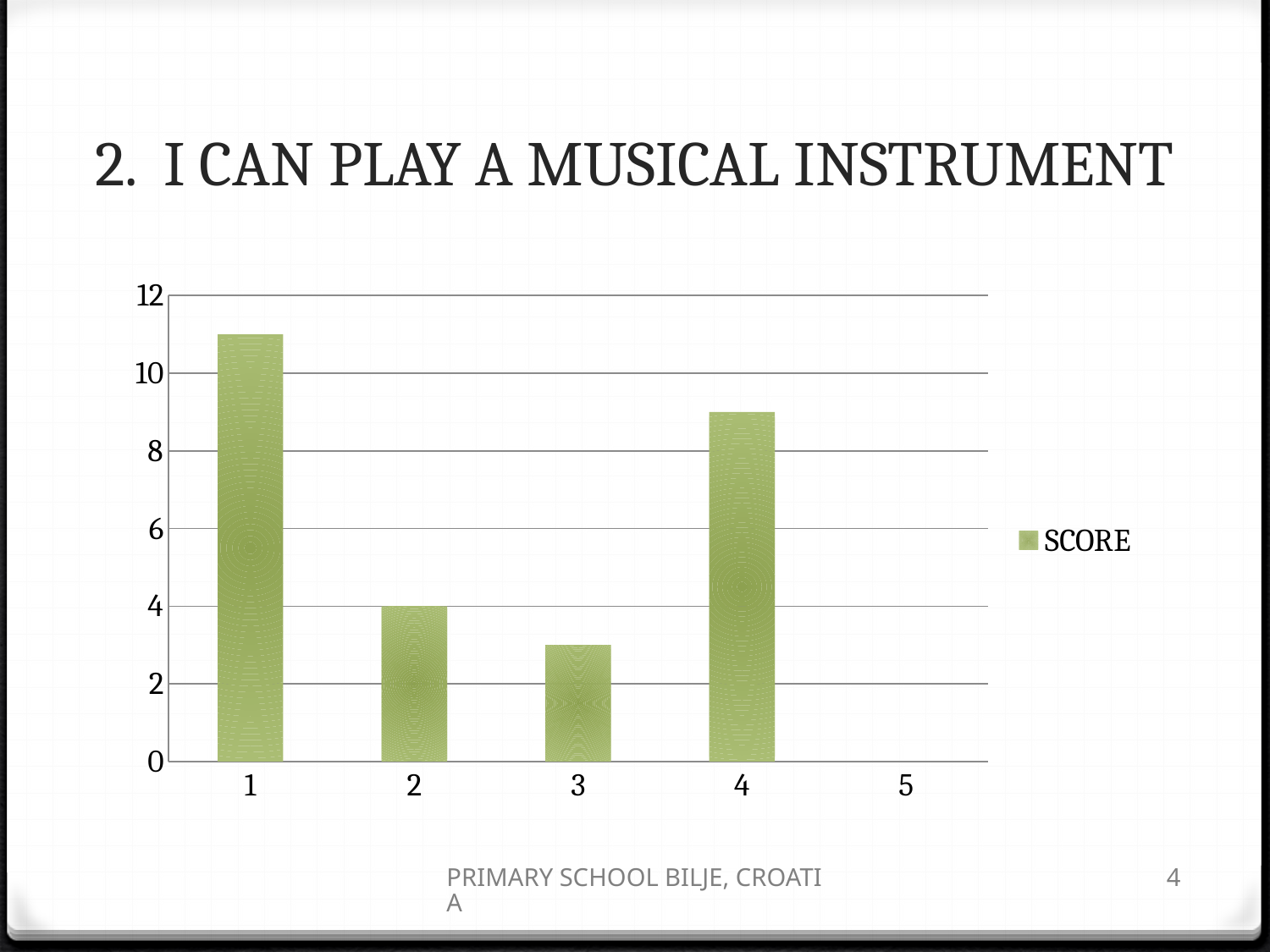
Is the value for category 4 greater or less than 8? greater Is the value for category 3 greater or less than 4? less What is the name of the series shown in the legend? SCORE How many categories are shown on the x axis? 5 Which category has the lowest SCORE? 5 Which category has the highest SCORE? 1 Which has a larger SCORE, category 2 or category 4? 4 What is the SCORE value for category 5? 0 How many series does the legend list? 1 What kind of chart is shown on the slide? bar chart What is the SCORE value for category 2? 4 Is the value for category 1 greater or less than 10? greater